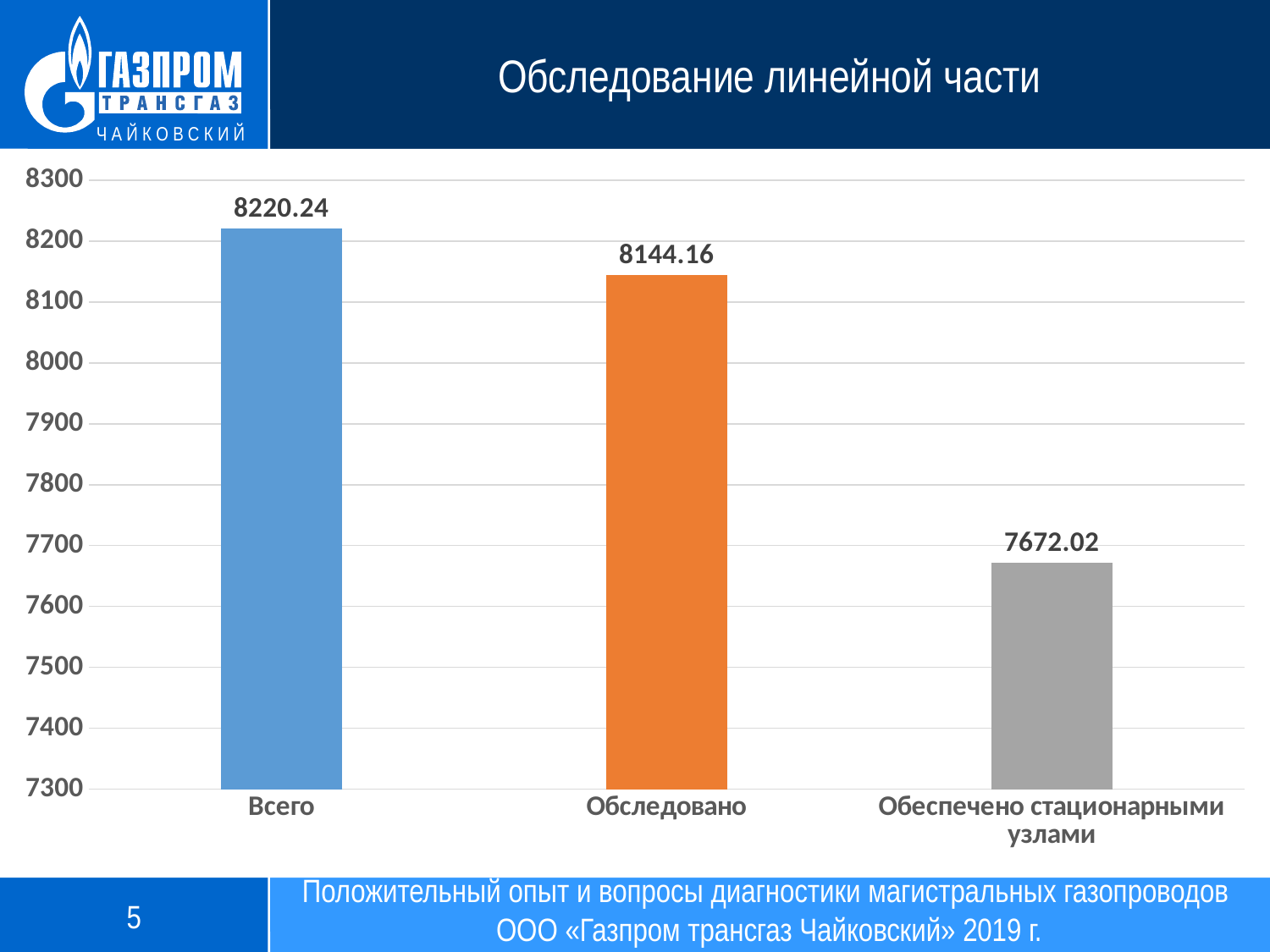
How many categories are shown on the chart? 3 What is the value for Обследовано? 8144.16 What is the value for Обеспечено стационарными узлами? 7672.02 What kind of chart is shown on the slide? bar chart Which category has the highest value? Всего What is the value for Всего? 8220.24 What is the difference between the values for Обследовано and Обеспечено стационарными узлами? 472.14 Do the values rise or fall from left to right across the categories? fall Is the value for Обеспечено стационарными узлами greater or less than 7700? less Which category has the lowest value? Обеспечено стационарными узлами Which is larger, the value for Обследовано or the value for Обеспечено стационарными узлами? Обследовано What is the difference between the values for Всего and Обследовано? 76.08